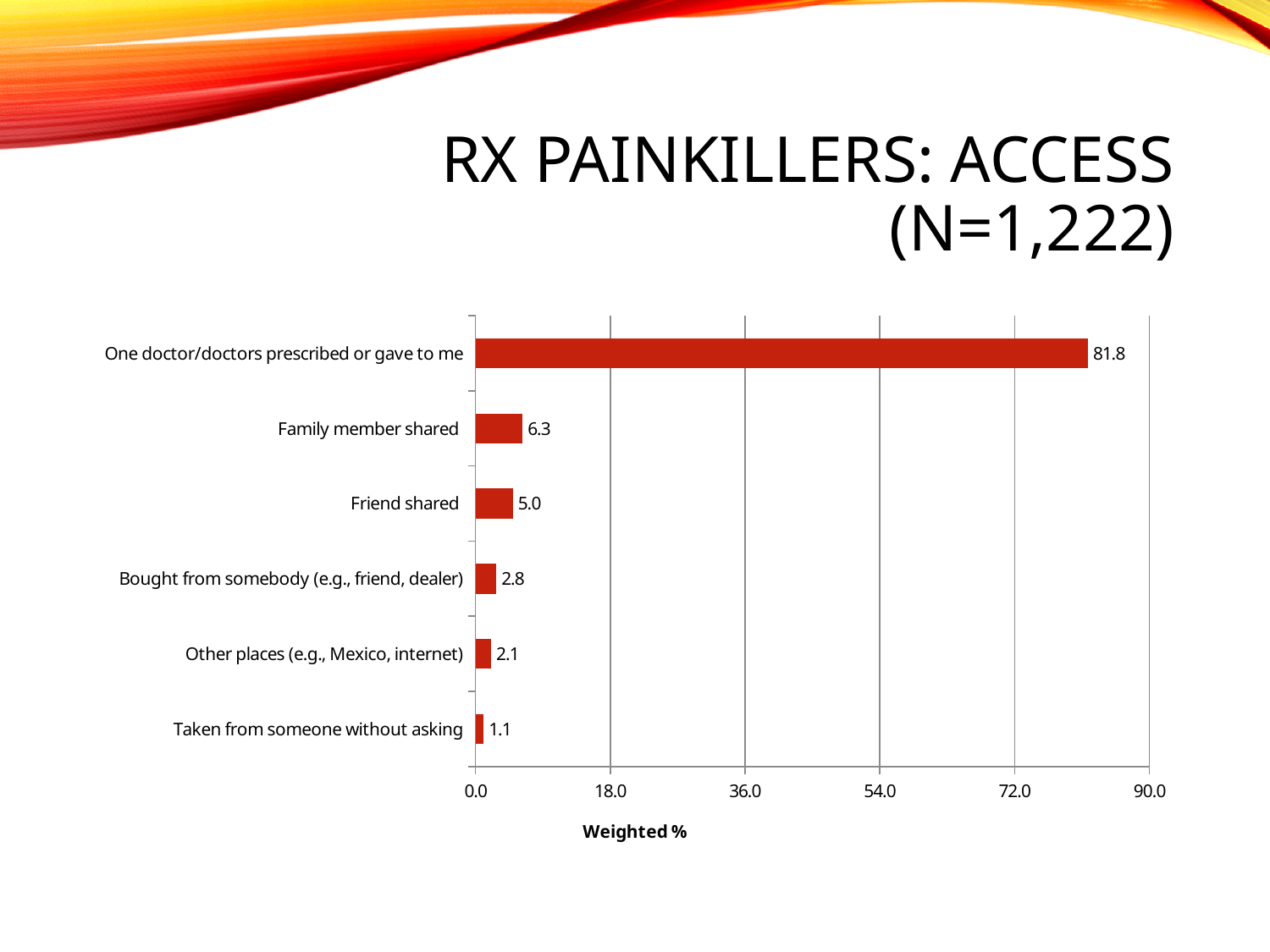
What is the weighted % for "Family member shared"? 6.3 How many categories are shown in the chart? 6 Is the value for "One doctor/doctors prescribed or gave to me" greater or less than 72.0? greater What is the weighted % for "Taken from someone without asking"? 1.1 What is the title of the slide? RX PAINKILLERS: ACCESS (N=1,222) Which category has the lowest weighted %? Taken from someone without asking What is the difference in weighted % between "Family member shared" and "Friend shared"? 1.3 What is the label on the horizontal axis of the chart? Weighted % Which category has the highest weighted %? One doctor/doctors prescribed or gave to me What is the weighted % for "One doctor/doctors prescribed or gave to me"? 81.8 Which is larger: the weighted % for "Bought from somebody (e.g., friend, dealer)" or for "Other places (e.g., Mexico, internet)"? Bought from somebody (e.g., friend, dealer) What kind of chart is shown on the slide? Bar chart